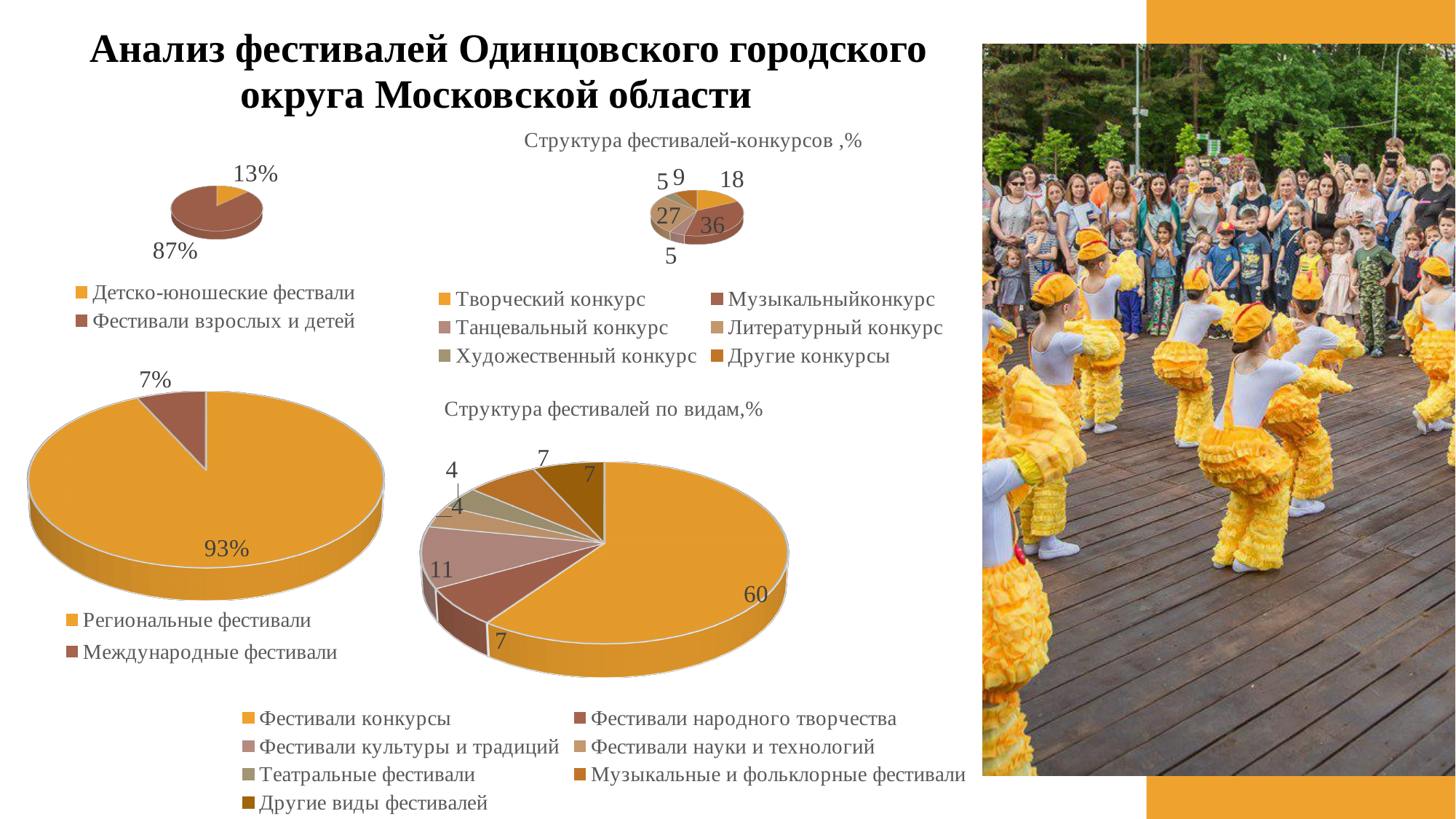
In the pie chart titled "Структура фестивалей-конкурсов ,%", which category has the largest share? Музыкальный конкурс In the pie chart titled "Структура фестивалей по видам,%", what is the value for Фестивали культуры и традиций? 11 In the pie chart titled "Структура фестивалей-конкурсов ,%", what is the value for Танцевальный конкурс? 5 In the pie chart titled "Структура фестивалей-конкурсов ,%", what is the difference between Музыкальный конкурс and Творческий конкурс? 18 In the pie chart titled "Структура фестивалей по видам,%", how many categories does the legend list? 7 In the pie chart titled "Структура фестивалей по видам,%", which is larger: Фестивали культуры и традиций or Фестивали народного творчества? Фестивали культуры и традиций In the pie chart titled "Структура фестивалей-конкурсов ,%", what is the value for Музыкальный конкурс? 36 In the top-left pie chart, what is the share for Фестивали взрослых и детей? 87% In the top-left pie chart, what is the share for Детско-юношеские фестивали? 13% What type of chart is used for "Структура фестивалей по видам,%"? Pie chart In the pie chart titled "Структура фестивалей по видам,%", what is the value for Фестивали конкурсы? 60 In the bottom-left pie chart, what is the share for Региональные фестивали? 93%